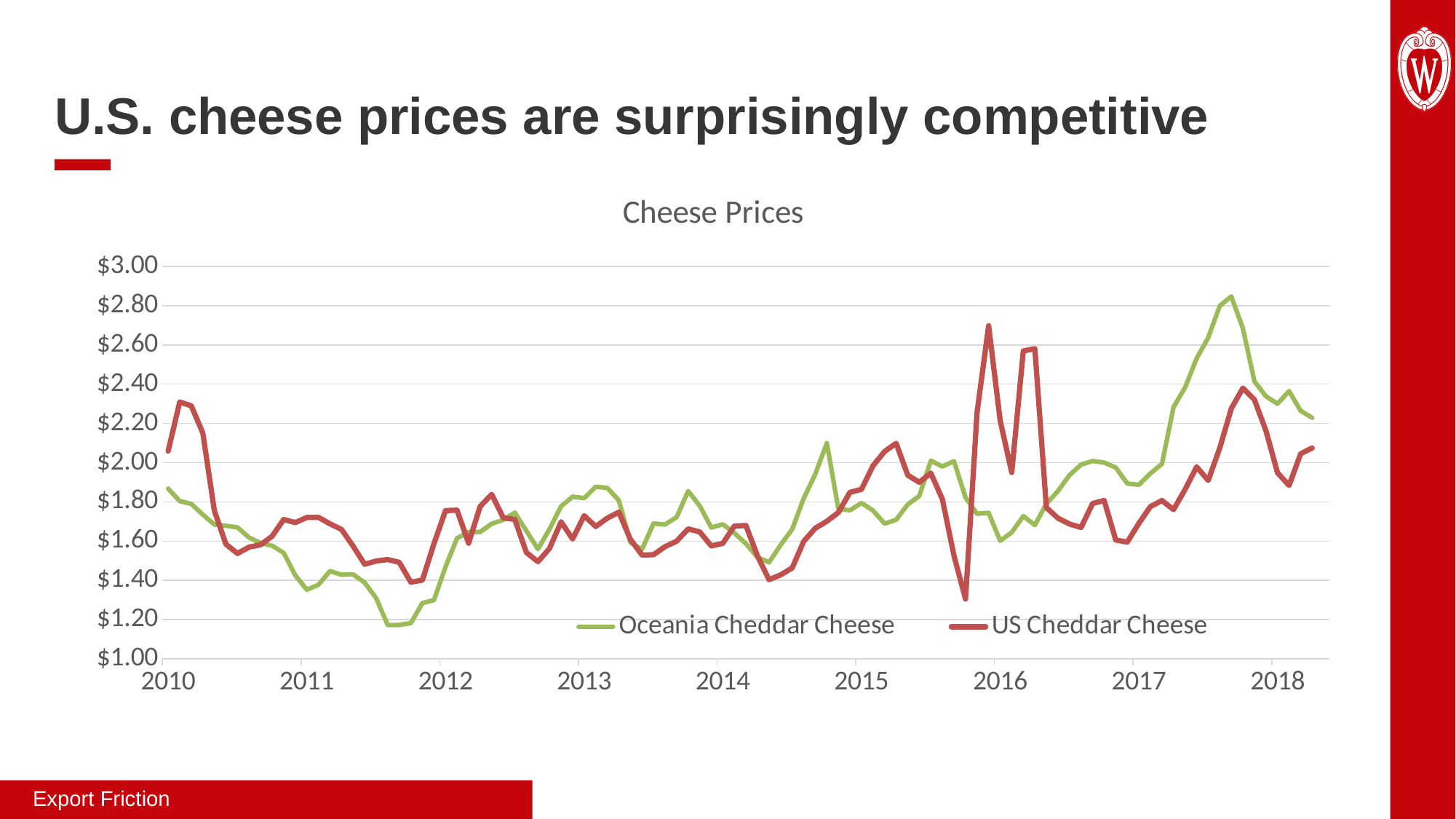
Which series reaches the lowest price anywhere on the chart? Oceania Cheddar Cheese What are the two series named in the legend of the Cheese Prices chart? Oceania Cheddar Cheese and US Cheddar Cheese Is the lowest value of the US Cheddar Cheese line in late 2015 greater or less than $1.60? less Does the Oceania Cheddar Cheese line rise or fall from the start of 2010 to late 2011? fall What is the title of the chart on the slide? Cheese Prices Is the peak value of the Oceania Cheddar Cheese line in late 2017 greater or less than $2.60? greater Which series reaches the highest price anywhere on the chart? Oceania Cheddar Cheese At the start of 2010, which series has the higher price, Oceania Cheddar Cheese or US Cheddar Cheese? US Cheddar Cheese Is the lowest value of the Oceania Cheddar Cheese line in late 2011 greater or less than $1.40? less What kind of chart is shown on the slide? line chart How many series does the legend of the Cheese Prices chart list? 2